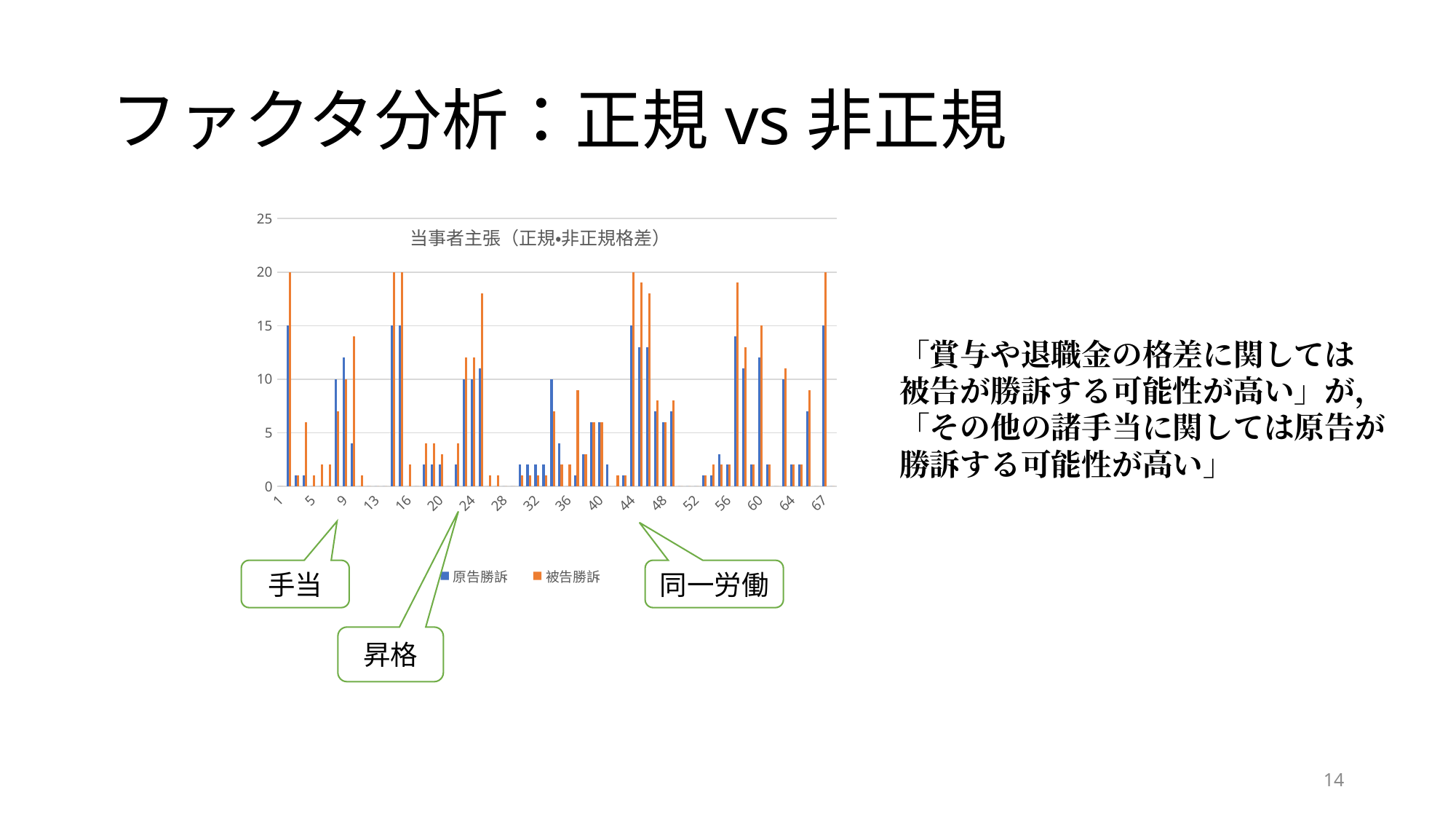
At category 67, which series has the larger value, 原告勝訴 or 被告勝訴? 被告勝訴 Is the 原告勝訴 value at category 67 greater or less than 10? greater What kind of chart is shown on the slide? bar chart How many series does the chart's legend list? 2 What is the title of the chart? 当事者主張（正規•非正規格差） What are the two series named in the chart's legend? 原告勝訴 and 被告勝訴 Is the 被告勝訴 value at category 5 greater or less than 10? less Is the 被告勝訴 value at category 67 greater or less than 15? greater